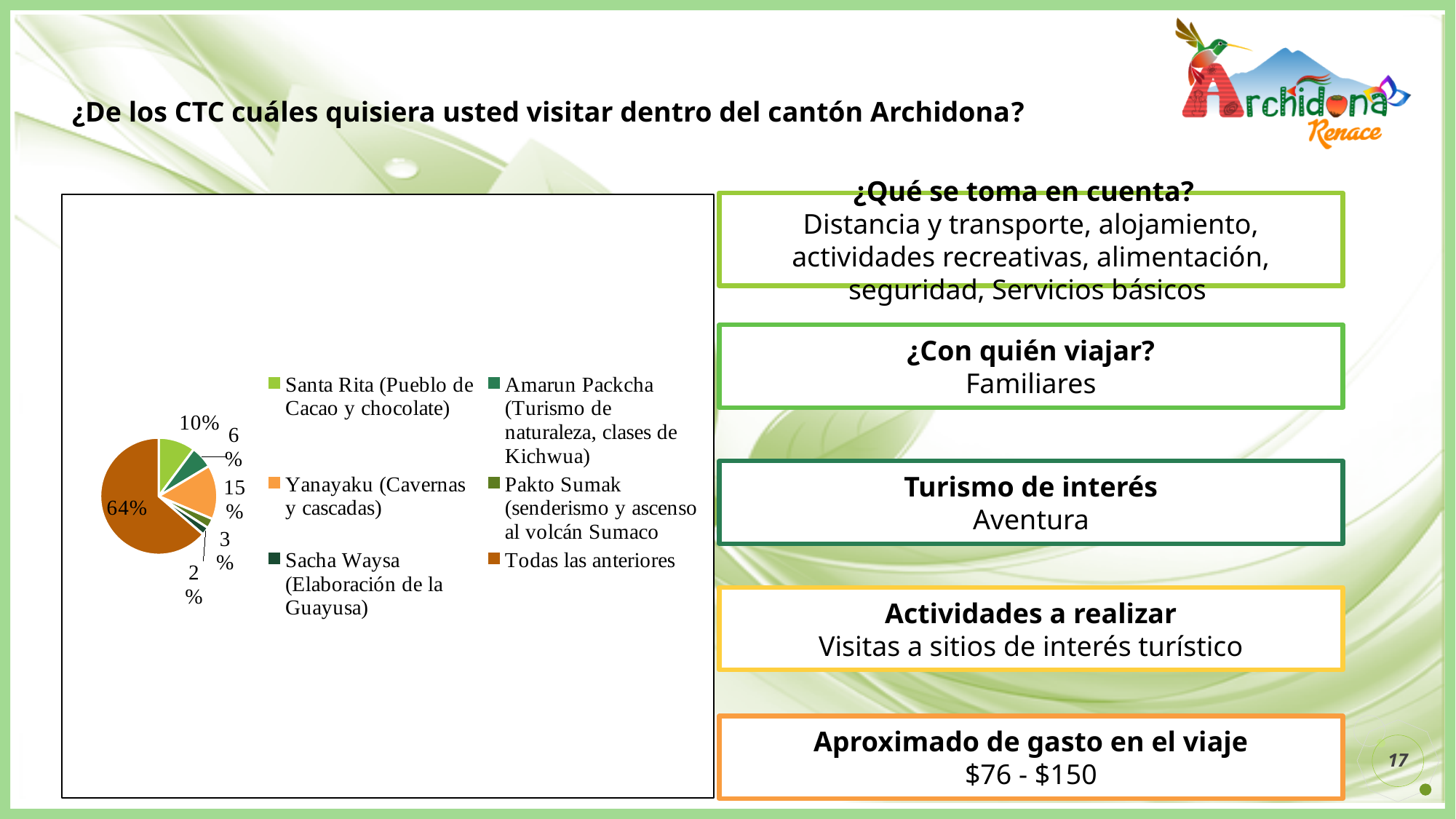
How many categories does the pie chart's legend list? 6 What percentage of the pie corresponds to "Todas las anteriores"? 64% What question does the slide title ask about the pie chart? ¿De los CTC cuáles quisiera usted visitar dentro del cantón Archidona? What colour is the slice for "Todas las anteriores" in the pie chart? brown Which category has the largest share of the pie? Todas las anteriores What kind of chart is shown on the slide? pie chart What is the smallest percentage shown on the pie chart? 2% By how many percentage points does the share for "Todas las anteriores" exceed the share for Yanayaku (Cavernas y cascadas)? 49 percentage points What percentage of the pie corresponds to Amarun Packcha (Turismo de naturaleza, clases de Kichwua)? 6% What percentage of the pie corresponds to Santa Rita (Pueblo de Cacao y chocolate)? 10% Which has a larger share of the pie, Santa Rita (Pueblo de Cacao y chocolate) or Yanayaku (Cavernas y cascadas)? Yanayaku (Cavernas y cascadas) What percentage of the pie corresponds to Yanayaku (Cavernas y cascadas)? 15%